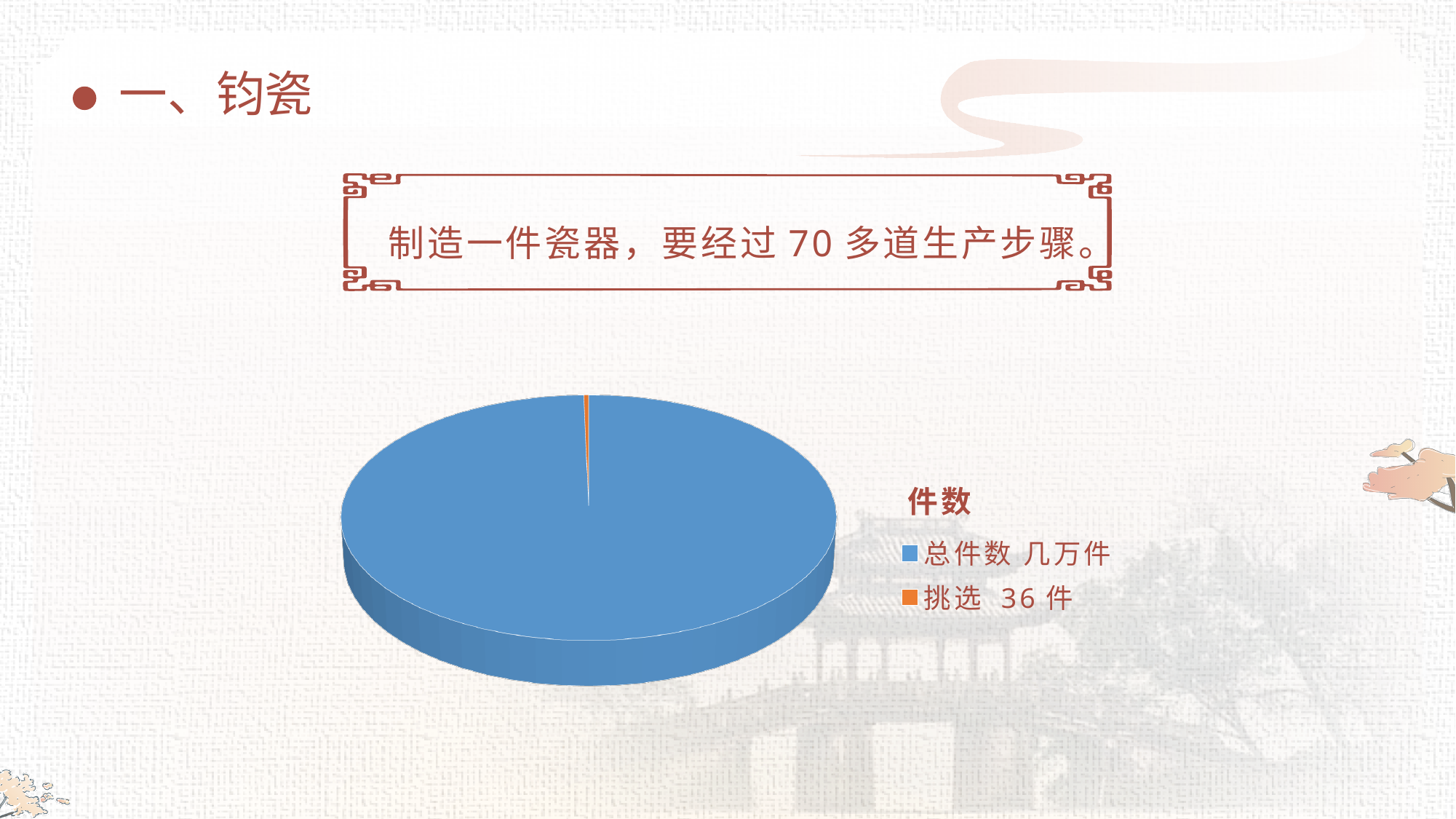
Which category takes up the largest share of the pie chart? 总件数 几万件 How many slices does the pie chart have? 2 Which category takes up the smallest share of the pie chart? 挑选 36 件 What colour is the 挑选 36 件 slice in the pie chart? orange Which slice is larger, 总件数 几万件 or 挑选 36 件? 总件数 几万件 What kind of chart is shown on the slide? pie chart What is the title of the pie chart? 件数 How many entries does the legend of the pie chart list? 2 Does the 挑选 36 件 slice take up more or less than half of the pie? less